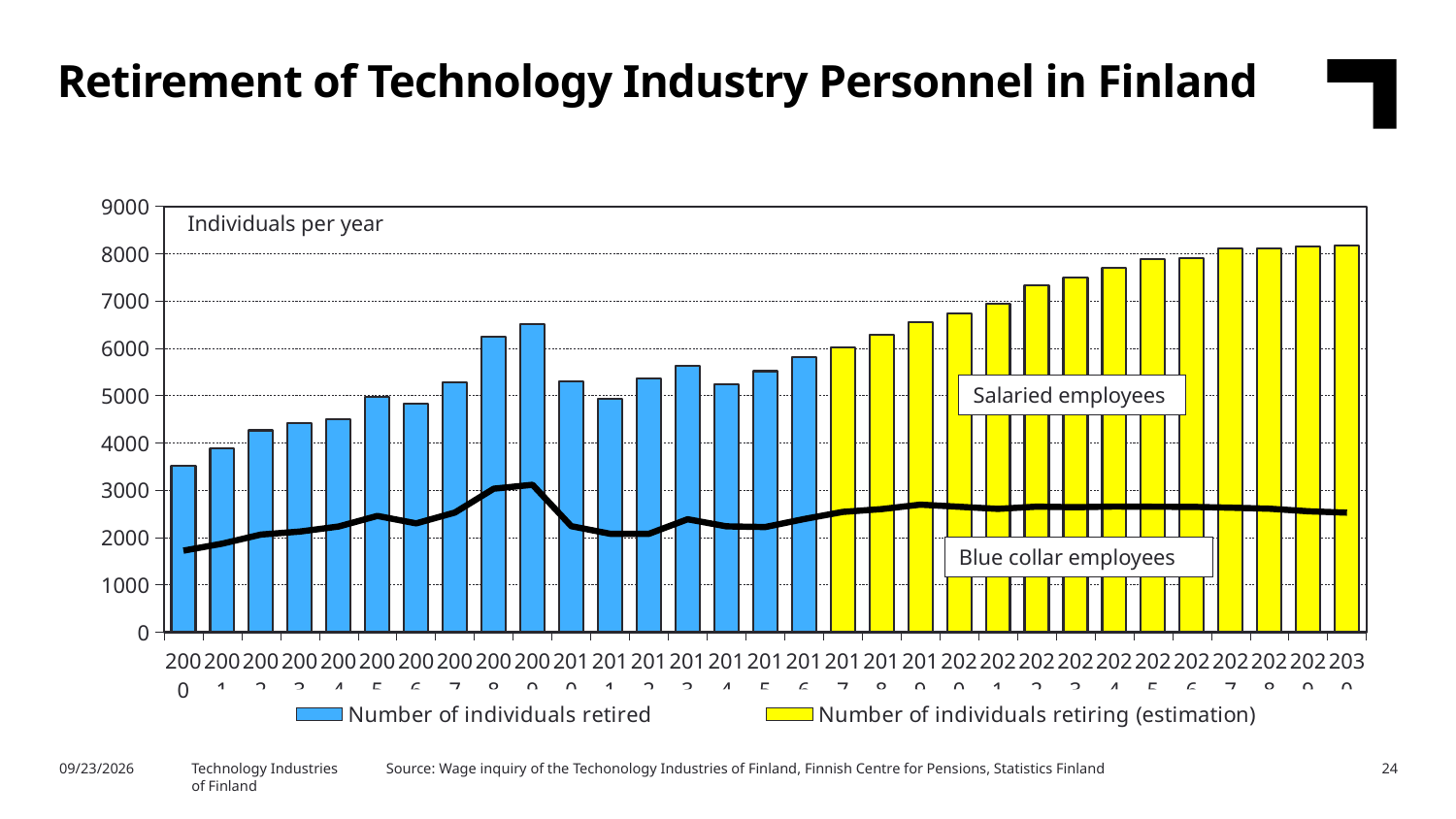
Do the estimated values (yellow bars) rise or fall from 2017 to 2030? Rise Which year has the lowest bar in the chart? 2000 Which bar is taller, 2008 or 2009? 2009 What kind of chart is shown on the slide? Combination bar and line chart What are the two series named in the legend? Number of individuals retired; Number of individuals retiring (estimation) What colour are the bars for the 'Number of individuals retiring (estimation)' series? Yellow Is the value for 2030 greater or less than 8000? greater How many years (bars) are shown on the x axis? 31 Is the value for 2009 greater or less than 6000? greater How many series does the legend list? 2 Is the value for 2016 greater or less than 6000? less